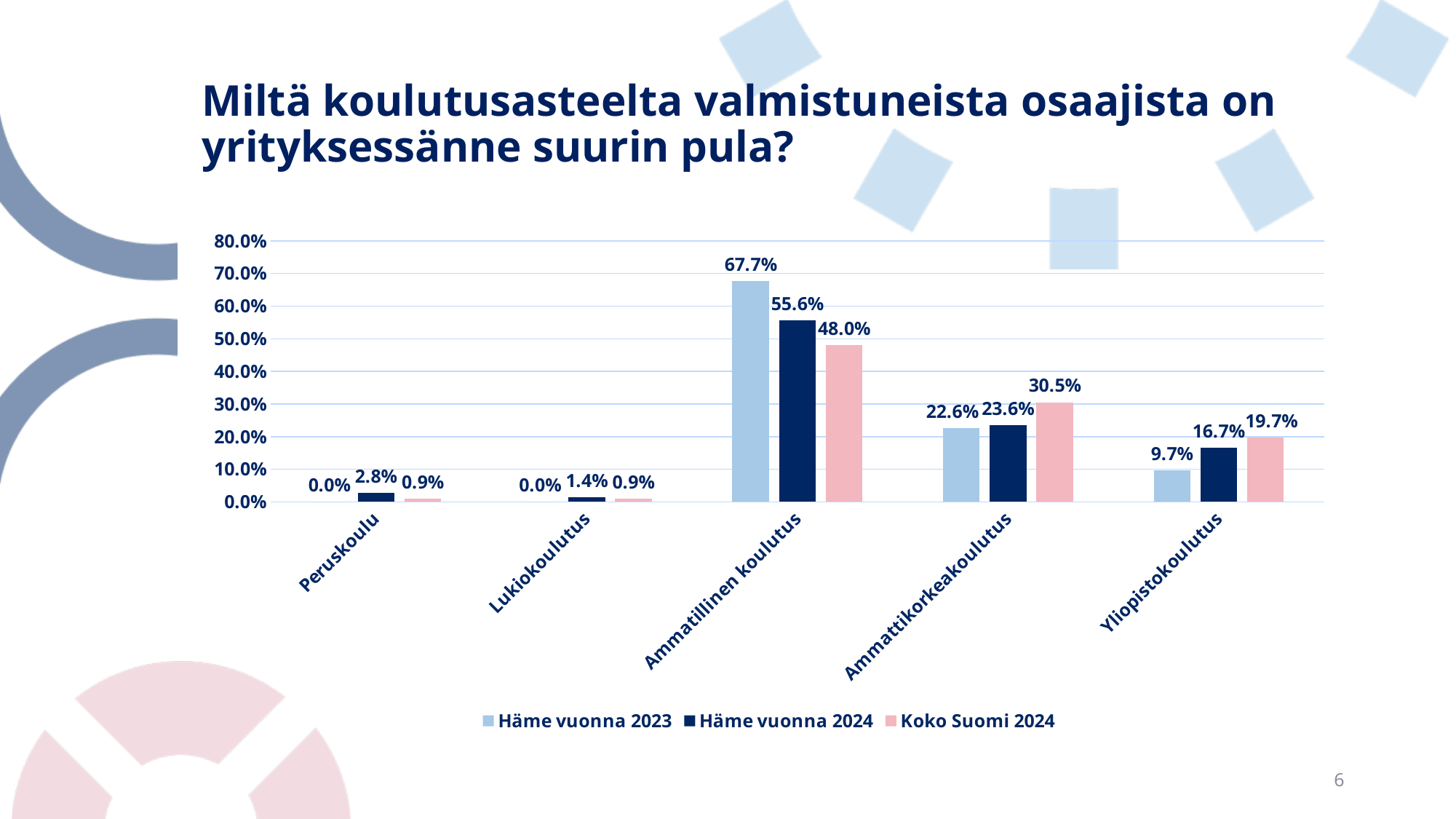
What is the value for Ammatillinen koulutus in the Häme vuonna 2023 series? 67.7% What kind of chart is shown on the slide? bar chart How many series does the legend list? 3 Which is larger for Ammattikorkeakoulutus: the Häme vuonna 2024 value or the Koko Suomi 2024 value? Koko Suomi 2024 Is the Häme vuonna 2023 value for Ammatillinen koulutus greater or less than 60.0%? greater Which category has the highest value in the Koko Suomi 2024 series? Ammatillinen koulutus What is the value for Yliopistokoulutus in the Koko Suomi 2024 series? 19.7% How many categories are shown on the x axis? 5 What is the difference between the Häme vuonna 2023 and Häme vuonna 2024 values for Ammatillinen koulutus? 12.1% Which category has the lowest value in the Häme vuonna 2024 series? Lukiokoulutus What is the value for Peruskoulu in the Häme vuonna 2024 series? 2.8% Which series is shown in pink in the legend? Koko Suomi 2024